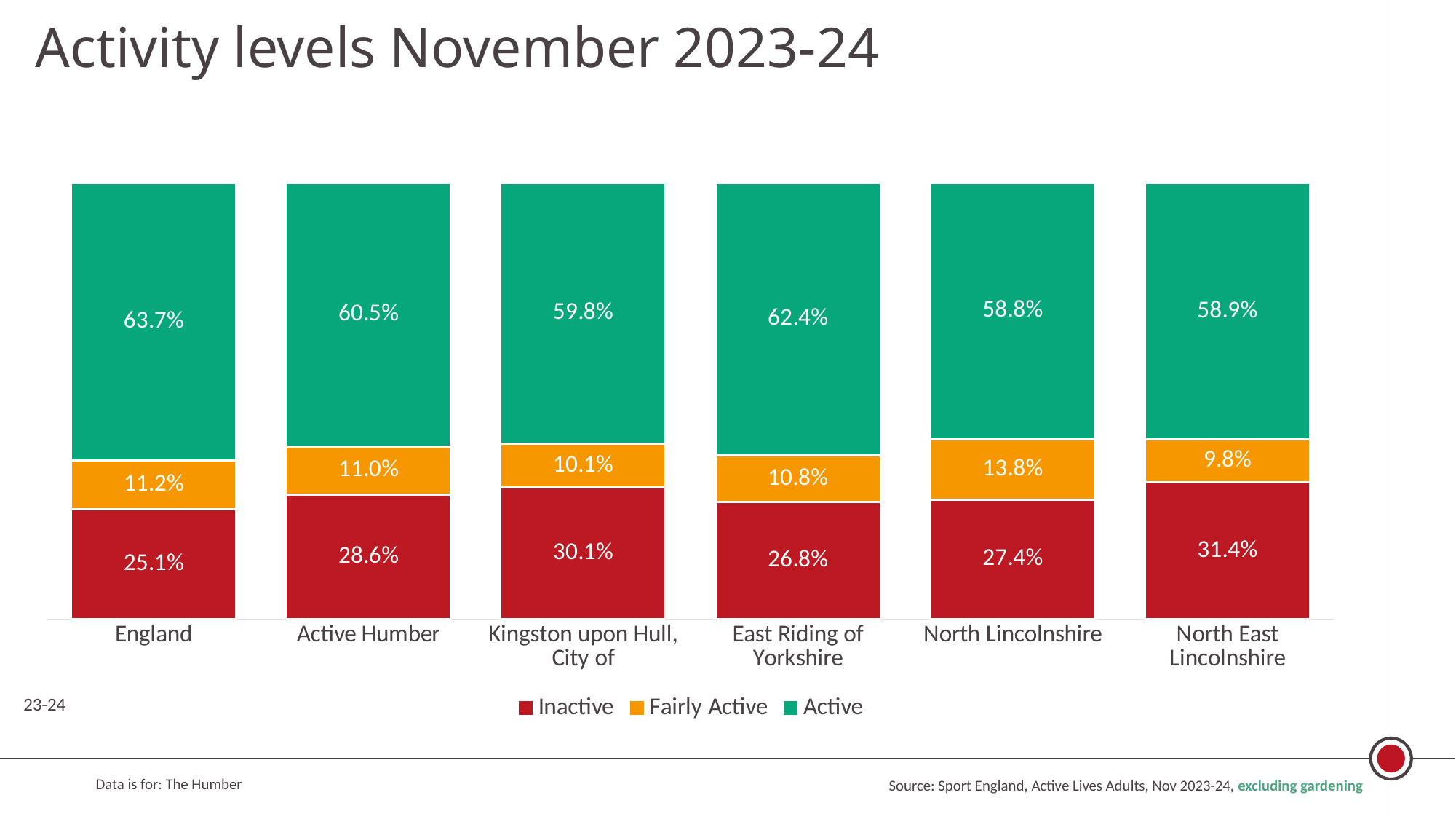
Which area has the highest Inactive percentage? North East Lincolnshire Which has a higher Active percentage, Active Humber or East Riding of Yorkshire? East Riding of Yorkshire What is the total of the stacked bar for England? 100.0% How many series does the legend list? 3 What is the Active percentage for England? 63.7% Which area has the highest Active percentage? England What is the Inactive percentage for Kingston upon Hull, City of? 30.1% What is the difference in Inactive percentage between North East Lincolnshire and England? 6.3 percentage points How many areas are shown on the x axis? 6 What kind of chart is shown on the slide? Stacked bar chart What is the Fairly Active percentage for North Lincolnshire? 13.8% Which area has the lowest Fairly Active percentage? North East Lincolnshire